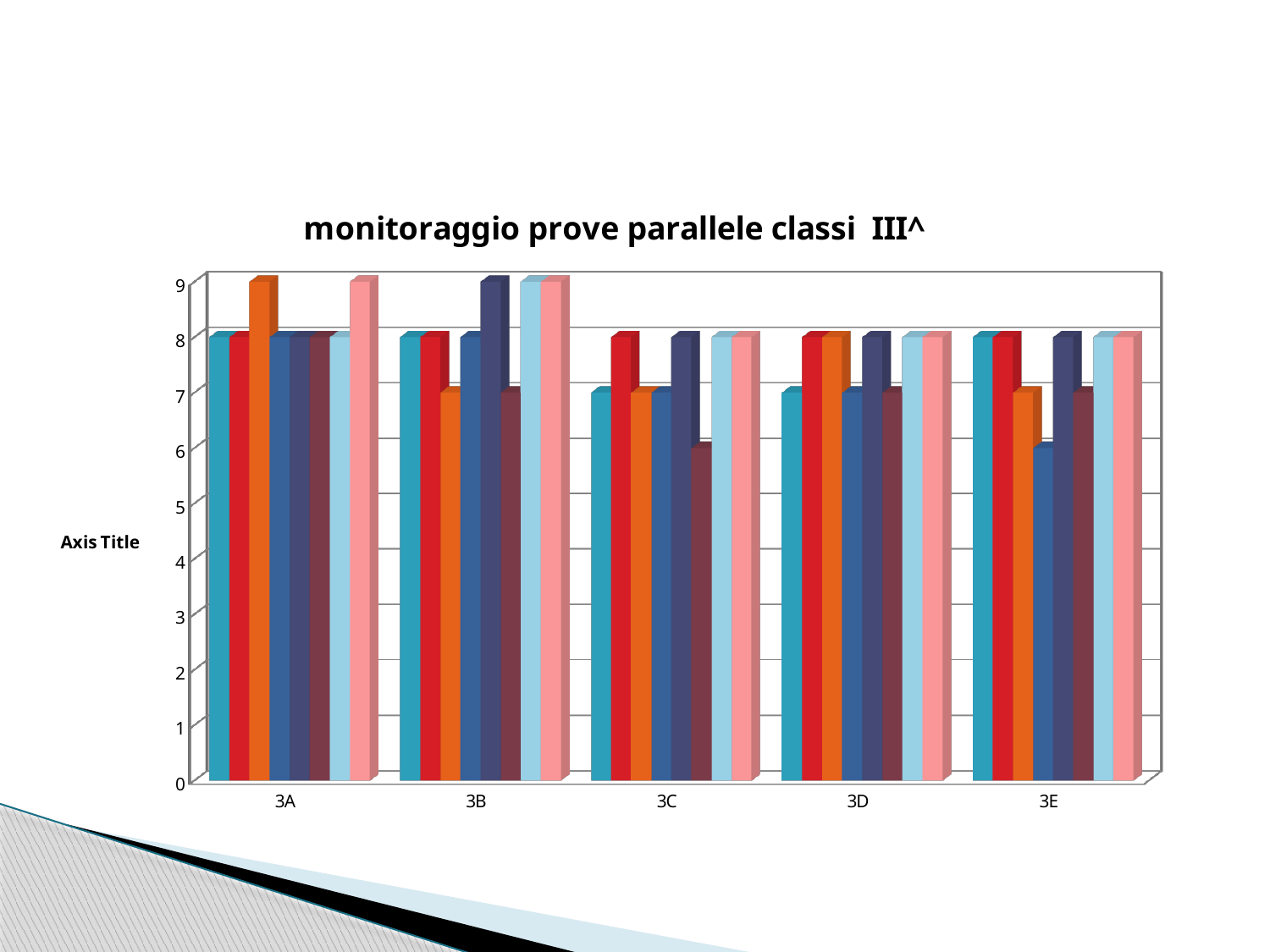
Is the value of the orange bar for 3A greater or less than 8? greater For category 3E, which is larger: the orange bar or the blue bar? orange Is the value of the blue bar for 3E greater or less than 7? less How many bars are plotted for each category in the chart? 8 What type of chart is shown on the slide? bar chart What is the highest value shown on the vertical axis of the chart? 9 What value does the orange bar for 3A reach on the axis? 9 How many categories are shown on the x axis of the chart? 5 What is the title of the chart? monitoraggio prove parallele classi III^ What value does the blue bar for 3E reach on the axis? 6 Is the value of the maroon bar for 3C greater or less than 7? less What is the label on the vertical axis of the chart? Axis Title